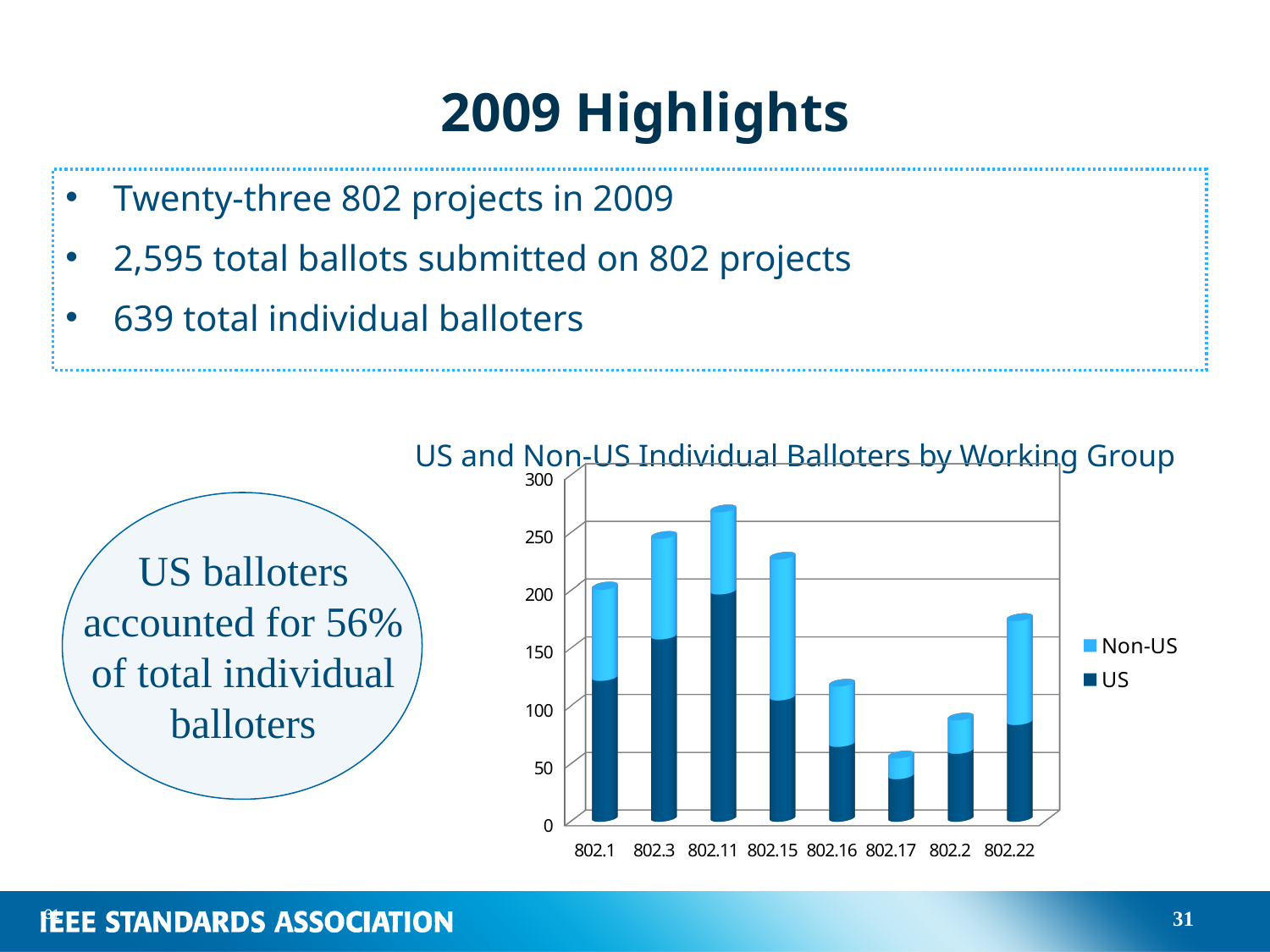
How many working groups are shown on the x axis of the chart? 8 Is the total bar height for 802.22 greater or less than 150? greater How many series does the chart's legend list? 2 What is the title of the chart? US and Non-US Individual Balloters by Working Group Which working group has the shortest stacked bar in the chart? 802.17 Which has the taller stacked bar, 802.3 or 802.16? 802.3 Is the total bar height for 802.17 greater or less than 100? less Which two series are listed in the chart's legend? Non-US and US What kind of chart is shown on the slide? bar chart Which working group has the tallest stacked bar in the chart? 802.11 Is the total bar height for 802.11 greater or less than 250? greater Which has the taller stacked bar, 802.11 or 802.15? 802.11